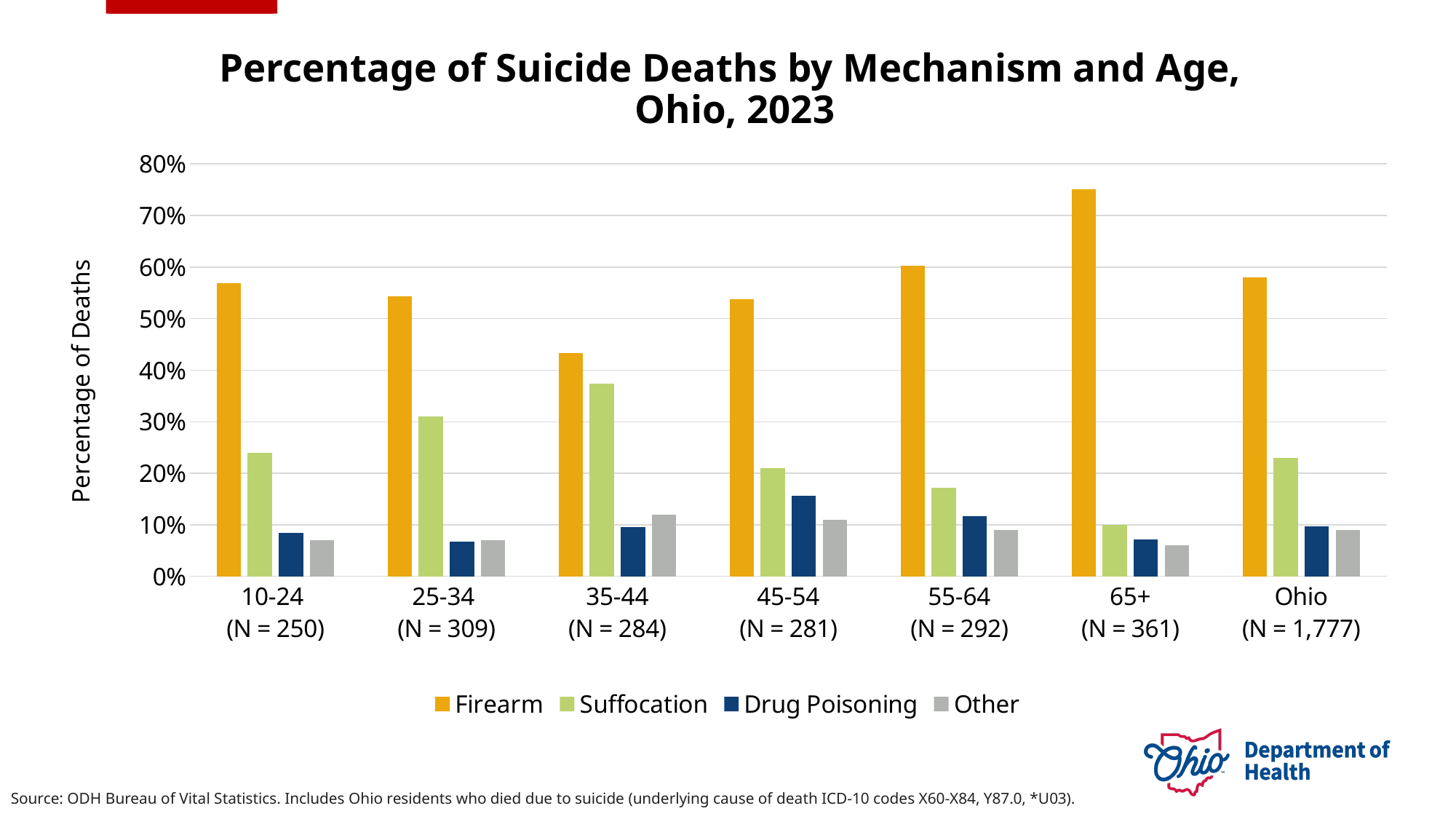
What is the N shown for the Ohio total category on the x axis? N = 1,777 Which age group has the highest percentage of suicide deaths by Suffocation? 35-44 How many age-group categories (including the Ohio total) are shown on the x axis? 7 Which age group has the lowest percentage of suicide deaths by Suffocation? 65+ Which age group has the highest percentage of suicide deaths by Drug Poisoning? 45-54 How many series does the legend list? 4 What kind of chart is shown on the slide? Bar chart Is the Suffocation value for the 35-44 age group greater or less than 40%? less For the 45-54 age group, which is larger: Drug Poisoning or Other? Drug Poisoning Which age group has the lowest percentage of suicide deaths by Firearm? 35-44 Which age group has the highest percentage of suicide deaths by Firearm? 65+ Is the Firearm value for the 65+ age group greater or less than 70%? greater